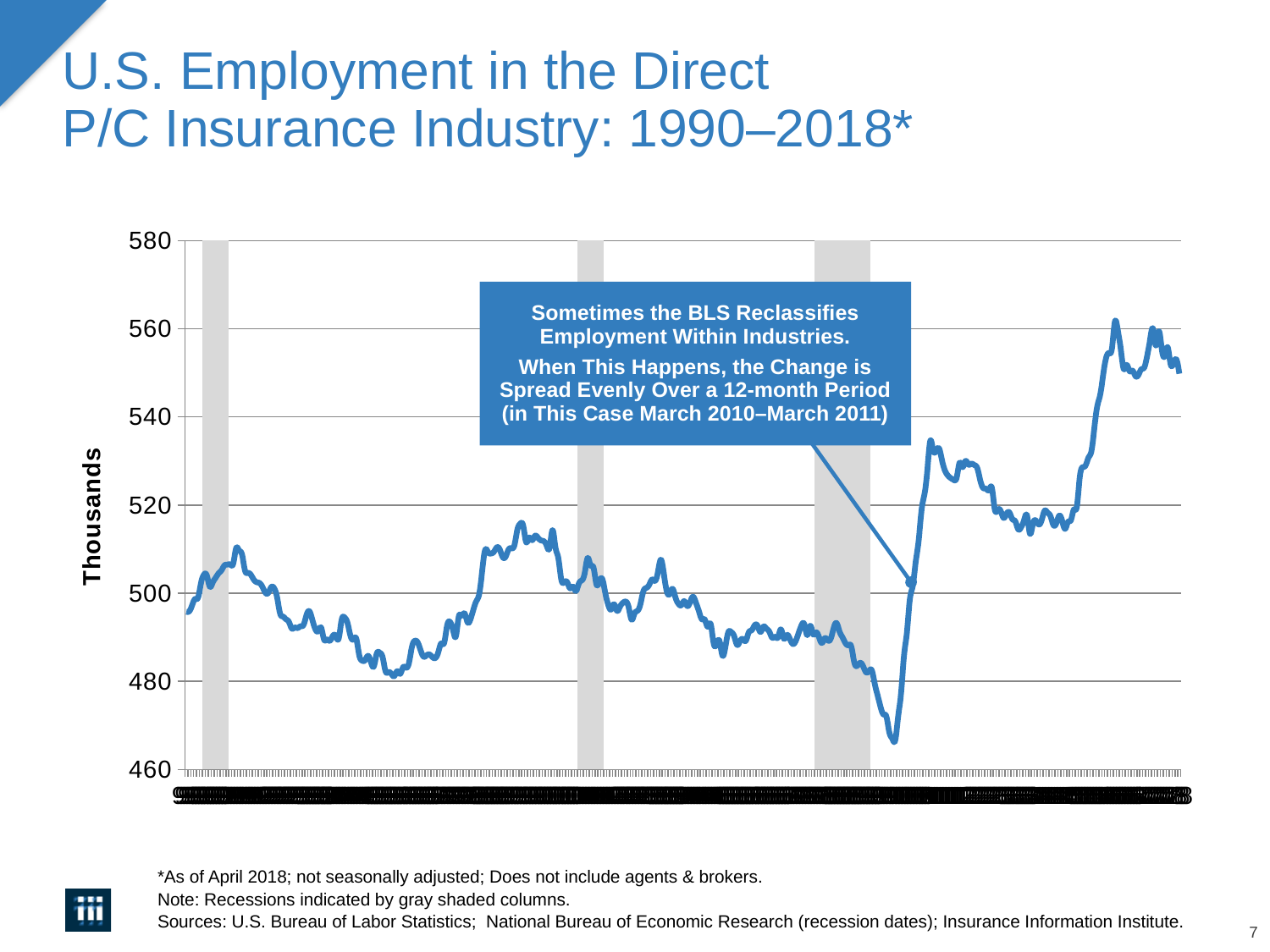
What is the lowest value shown on the vertical axis? 460 What kind of chart is shown on the slide? Line chart What is the label on the vertical axis of the chart? Thousands Is the value at the end of the series greater or less than 560? less Is the value at the end of the series (right end of the line) greater or less than 540? greater Comparing the start of the series to the end of the series, does employment rise or fall overall? rise How many gray shaded recession columns appear on the chart? 3 What is the highest value shown on the vertical axis? 580 Is the value at the start of the series (left end of the line) greater or less than 500? less Which is larger: the value at the end of the series or the value at the start of the series? the end of the series